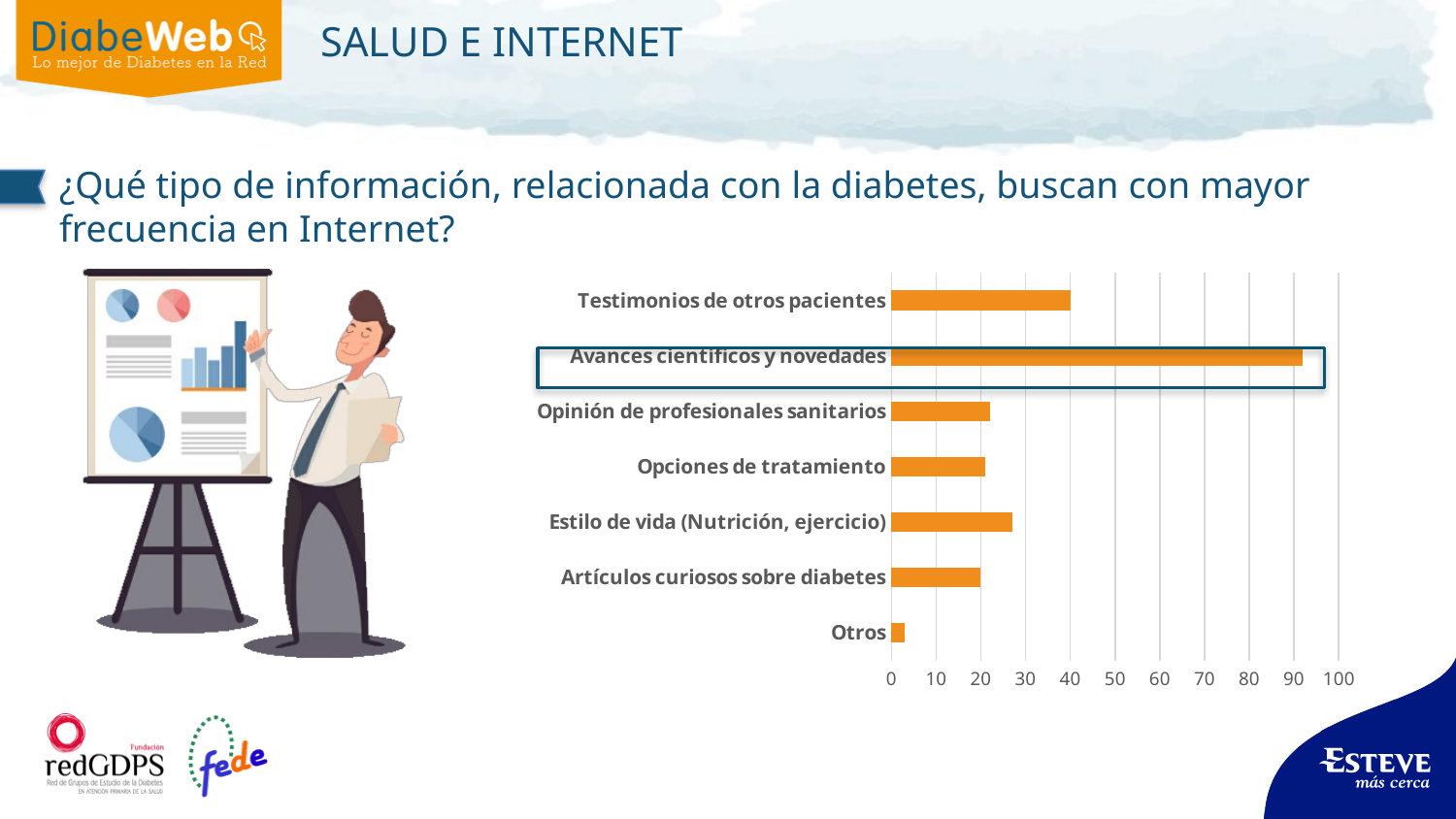
What is the maximum value shown on the chart's horizontal axis? 100 How many categories does the bar chart show? 7 Is the value for Opinión de profesionales sanitarios greater or less than 30? less Which is larger, the value for Testimonios de otros pacientes or the value for Avances científicos y novedades? Avances científicos y novedades What kind of chart is shown on the slide? bar chart Which is larger, the value for Estilo de vida (Nutrición, ejercicio) or the value for Opinión de profesionales sanitarios? Estilo de vida (Nutrición, ejercicio) Is the value for Estilo de vida (Nutrición, ejercicio) greater or less than 20? greater Which category has the highest value in the bar chart? Avances científicos y novedades Which category has the lowest value in the bar chart? Otros Is the value for Otros greater or less than 10? less